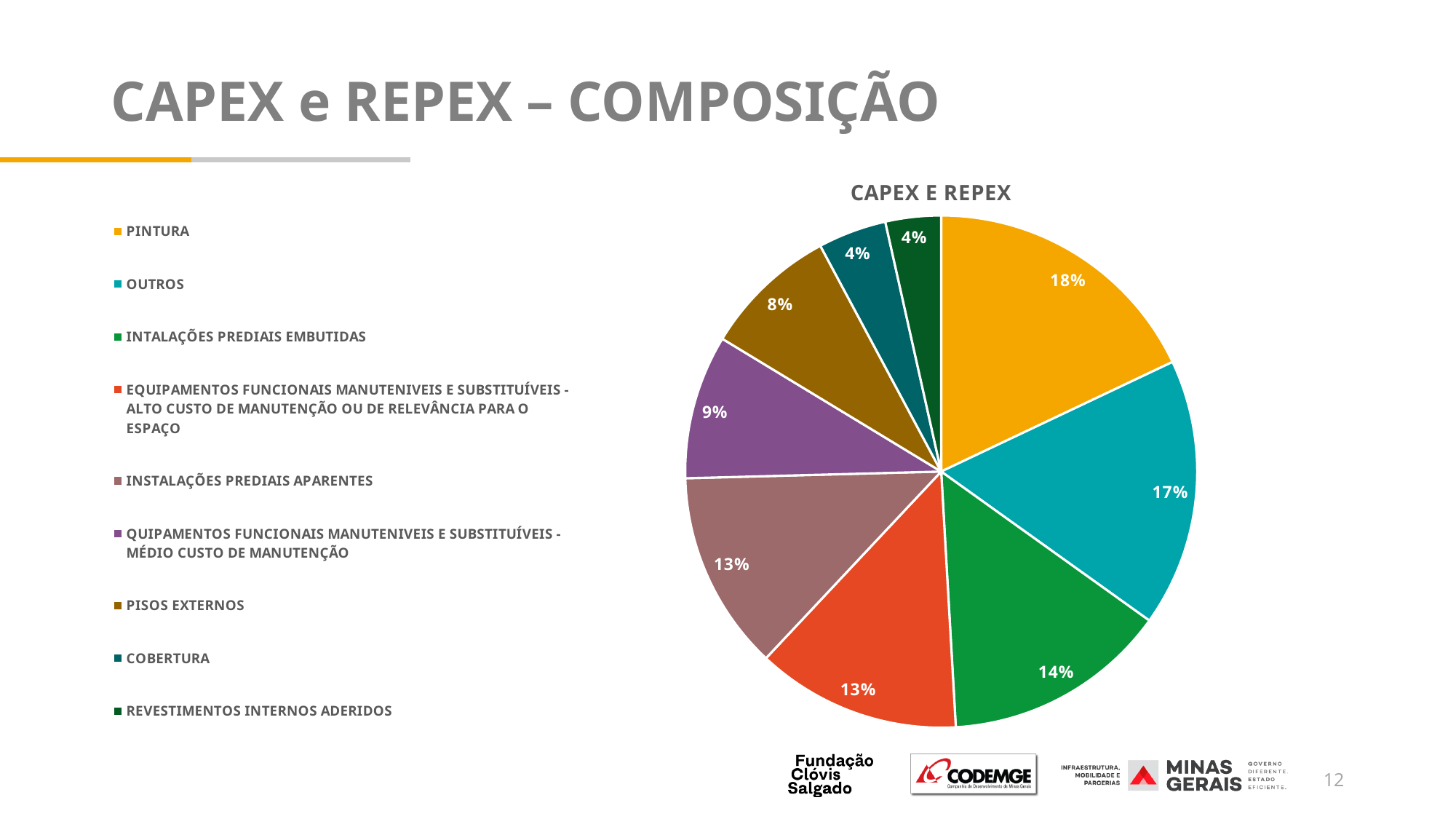
What share of the pie does OUTROS represent? 17% How many slices does the pie chart have? 9 What is the value shown for COBERTURA? 4% What is the value shown for PISOS EXTERNOS? 8% What colour is the slice for PINTURA? yellow What share of the pie does PINTURA represent? 18% What is the value shown for INTALAÇÕES PREDIAIS EMBUTIDAS? 14% What is the difference between the shares of PINTURA and PISOS EXTERNOS? 10% Which is larger, the share for OUTROS or the share for INSTALAÇÕES PREDIAIS APARENTES? OUTROS Which category has the largest share of the pie? PINTURA What kind of chart is shown on the slide? pie chart What is the title of the chart? CAPEX E REPEX